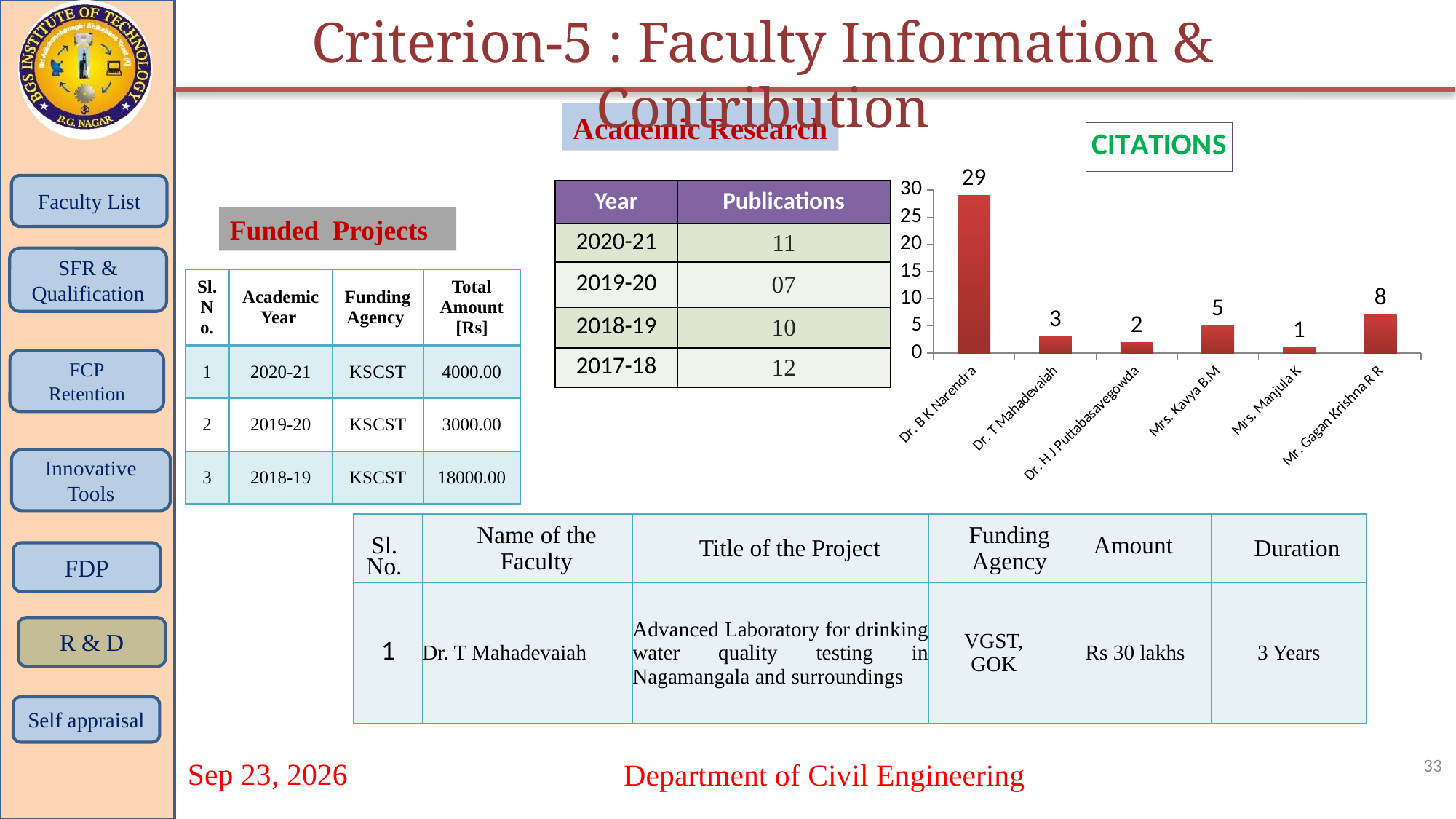
In the CITATIONS chart, what is the value for Mr. Gagan Krishna R R? 8 In the CITATIONS chart, who has more citations, Dr. T Mahadevaiah or Mrs. Kavya B.M? Mrs. Kavya B.M What is the title of the chart on the slide? CITATIONS In the CITATIONS chart, which faculty member has the lowest number of citations? Mrs. Manjula K In the CITATIONS chart, what is the difference between the citations of Dr. B K Narendra and Mr. Gagan Krishna R R? 21 What type of chart is the CITATIONS chart? bar chart In the CITATIONS chart, what is the value for Dr. H J Puttabasavegowda? 2 In the CITATIONS chart, is the value for Dr. B K Narendra greater or less than 25? greater In the CITATIONS chart, how many citations are shown for Dr. B K Narendra? 29 In the CITATIONS chart, what is the value for Mrs. Kavya B.M? 5 In the CITATIONS chart, which faculty member has the highest number of citations? Dr. B K Narendra How many faculty members are shown in the CITATIONS chart? 6